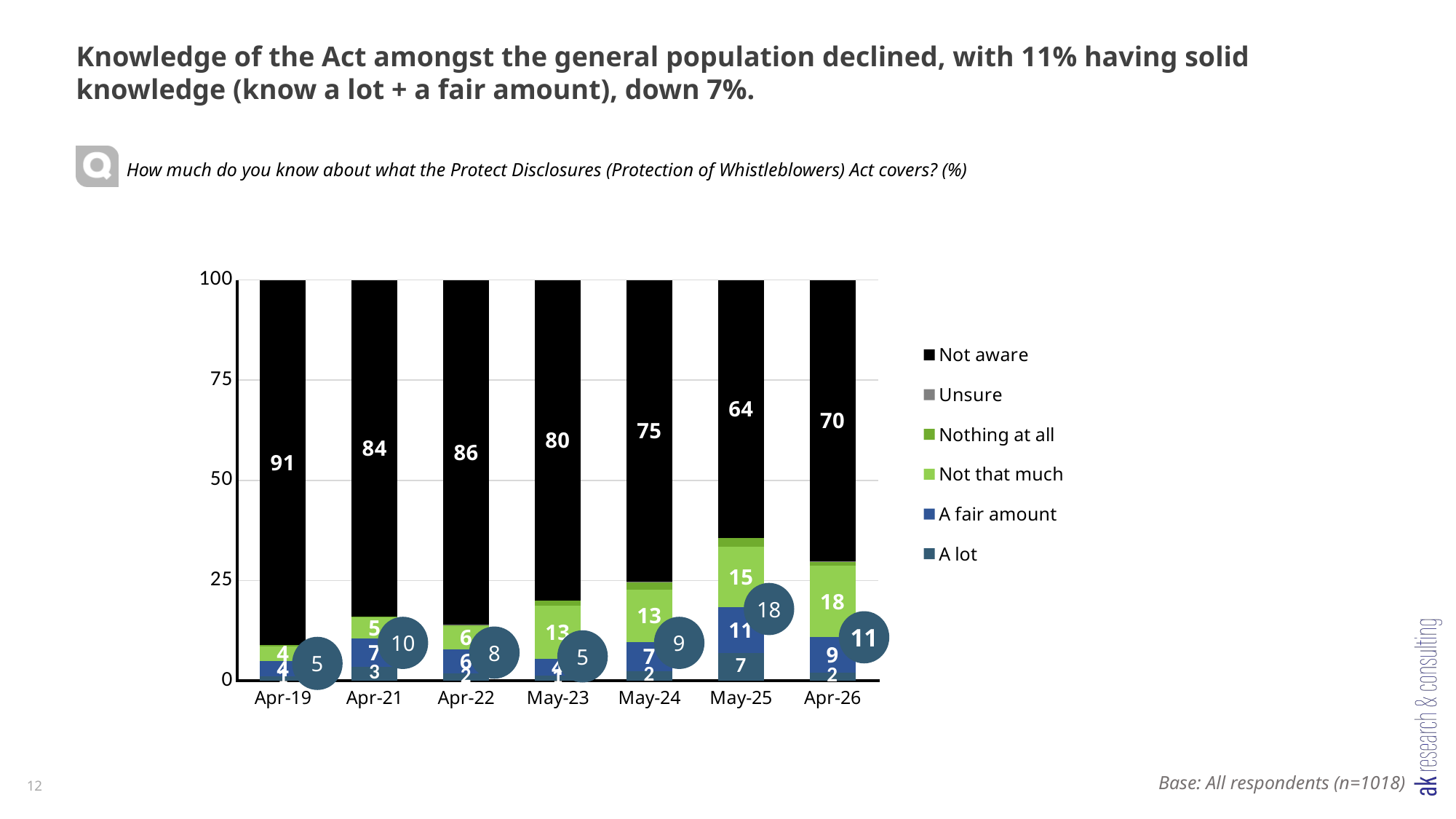
What is the 'Not aware' value for Apr-19? 91 What is the 'A fair amount' value for May-25? 11 Does the 'Not aware' value generally rise or fall from Apr-19 to Apr-26? fall What is the 'Not that much' value for Apr-26? 18 What value is shown in the circle next to the Apr-26 bar? 11 What is the difference between the 'Not aware' values for May-25 and Apr-26? 6 In which period is the 'Not aware' value highest? Apr-19 Which is larger, the 'Not that much' value for May-24 or for May-25? May-25 How many series does the legend list? 6 In which period is the 'Not aware' value lowest? May-25 What type of chart is shown on the slide? stacked bar chart How many time periods are shown on the x axis? 7